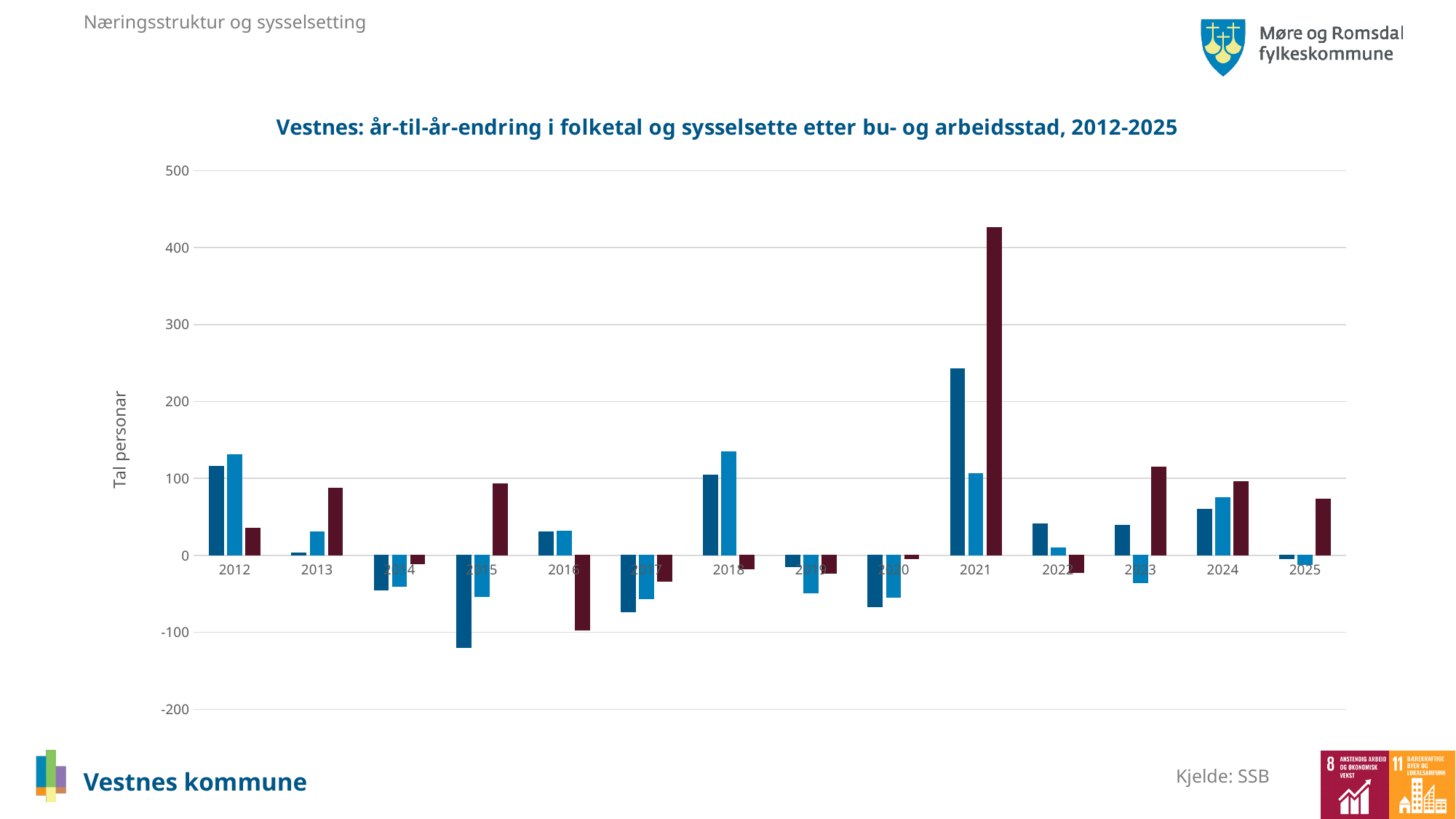
Is the value of the dark blue bar for 2015 greater or less than -100? less In which year is the dark red bar the highest? 2021 How many years are shown along the x axis of the chart? 14 What is the title of the chart? Vestnes: år-til-år-endring i folketal og sysselsette etter bu- og arbeidsstad, 2012-2025 Is the value of the dark red bar for 2021 greater or less than 400? greater Is the value of the dark blue bar for 2021 greater or less than 200? greater What kind of chart is shown on the slide? bar chart What is the label on the vertical axis of the chart? Tal personar In 2021, which is larger: the dark red bar or the dark blue bar? the dark red bar In which year is the dark blue bar the highest? 2021 In which year is the dark blue bar the lowest? 2015